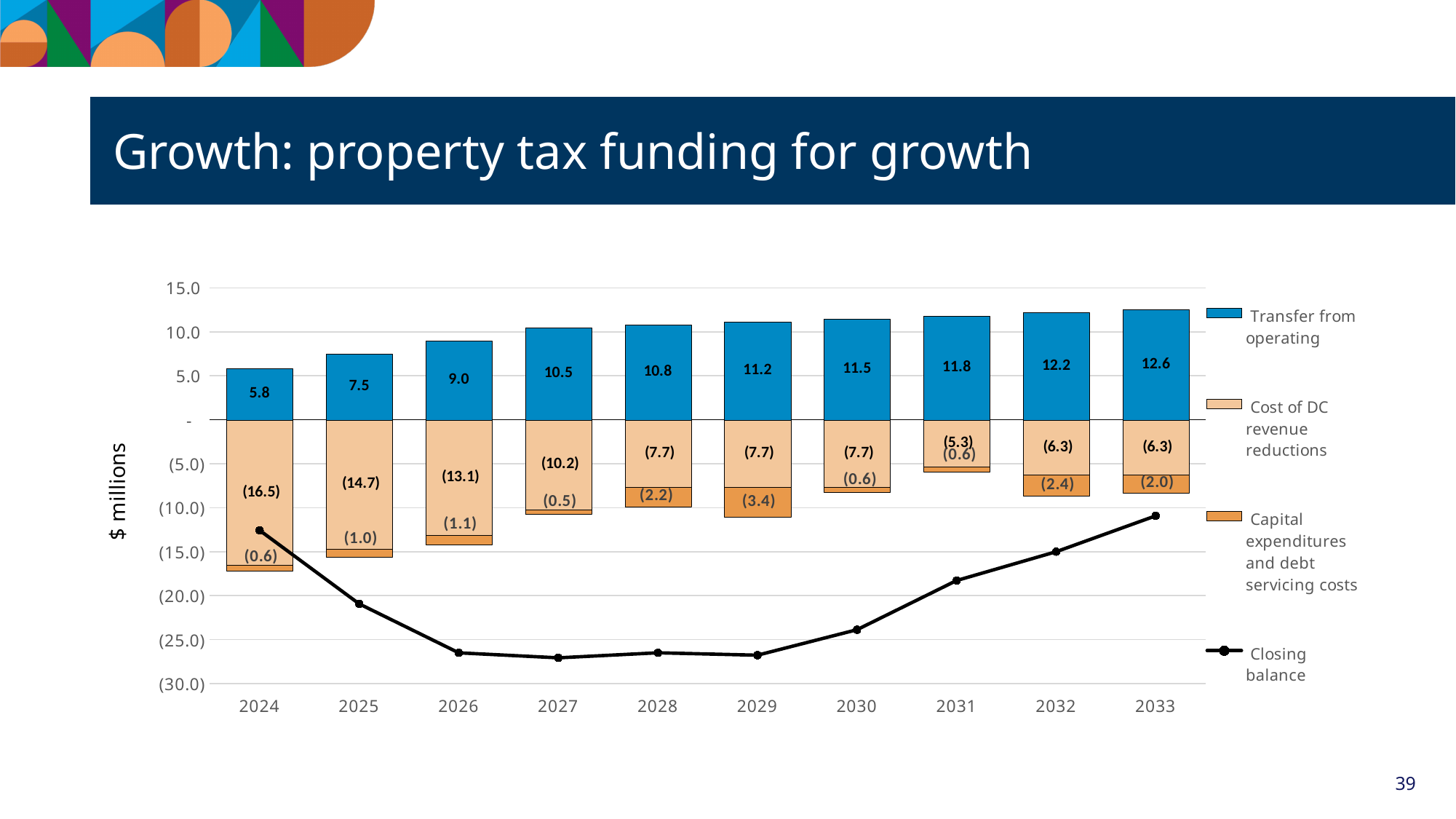
Which year has the smallest Capital expenditures and debt servicing costs value? 2027 How many years are shown on the x axis? 10 What is the value of Capital expenditures and debt servicing costs for 2029? (3.4) What is the value of Transfer from operating for 2024? 5.8 Is the Closing balance for 2033 greater or less than (15.0)? greater Is the Closing balance for 2027 greater or less than (25.0)? less What is the value of Cost of DC revenue reductions for 2025? (14.7) What is the difference between the Transfer from operating values for 2033 and 2024? 6.8 Does the Transfer from operating value rise or fall from 2024 to 2033? rise How many series does the legend list? 4 Which year has the highest Transfer from operating value? 2033 Is the Cost of DC revenue reductions larger in magnitude for 2024 or for 2031? 2024